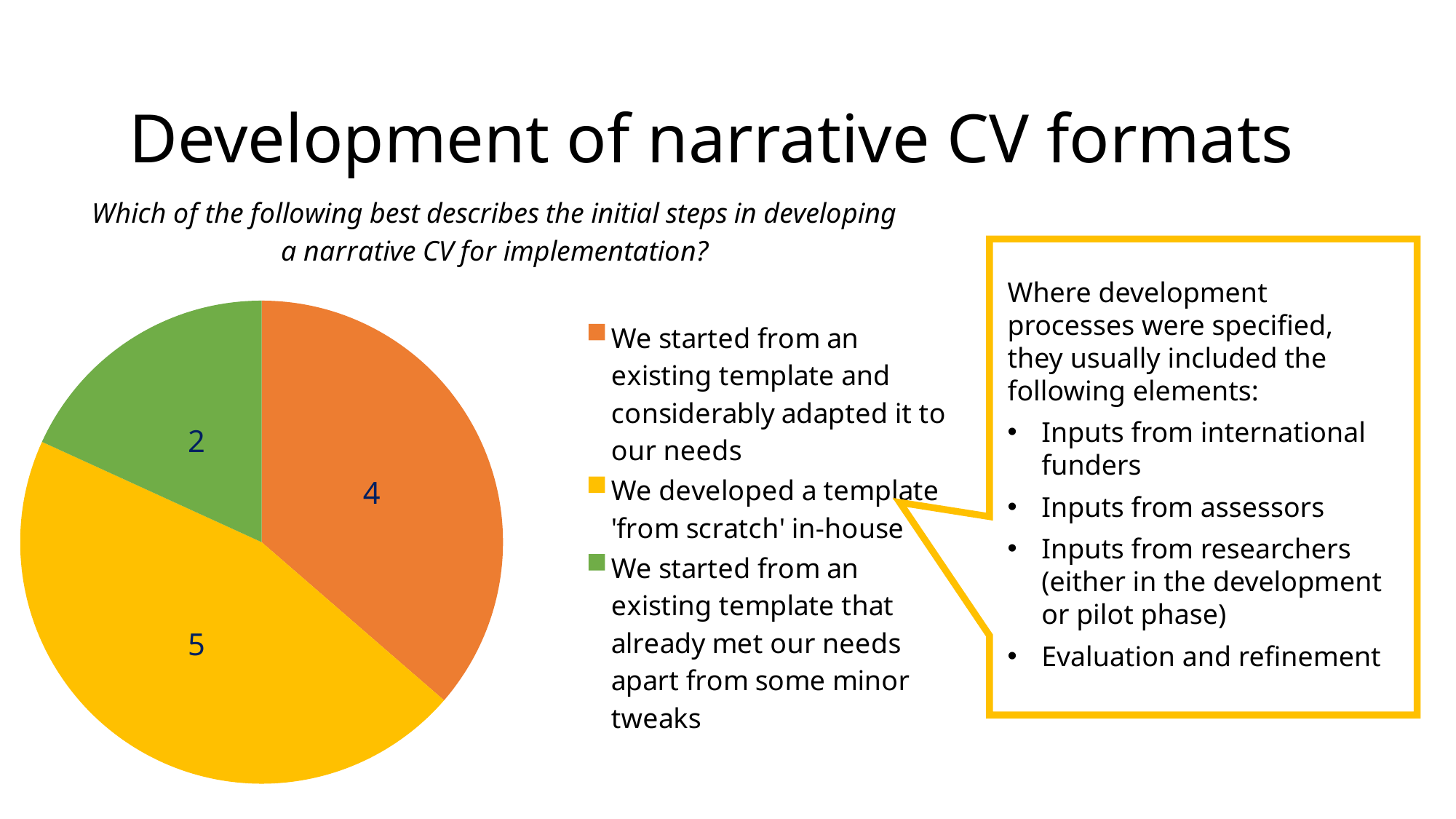
What type of chart is shown on the slide? pie chart Which category has the largest slice of the pie chart? We developed a template 'from scratch' in-house What is the difference between the value for 'We developed a template 'from scratch' in-house' and the value for 'We started from an existing template that already met our needs apart from some minor tweaks'? 3 Which category has the smallest slice of the pie chart? We started from an existing template that already met our needs apart from some minor tweaks What is the value for 'We developed a template 'from scratch' in-house'? 5 What colour is the slice for 'We developed a template 'from scratch' in-house'? yellow What is the value for 'We started from an existing template and considerably adapted it to our needs'? 4 What is the total of all the values shown in the pie chart? 11 How many slices does the pie chart have? 3 How many entries does the legend of the pie chart list? 3 What is the value for 'We started from an existing template that already met our needs apart from some minor tweaks'? 2 Which is larger: the value for 'We started from an existing template and considerably adapted it to our needs' or the value for 'We developed a template 'from scratch' in-house'? We developed a template 'from scratch' in-house